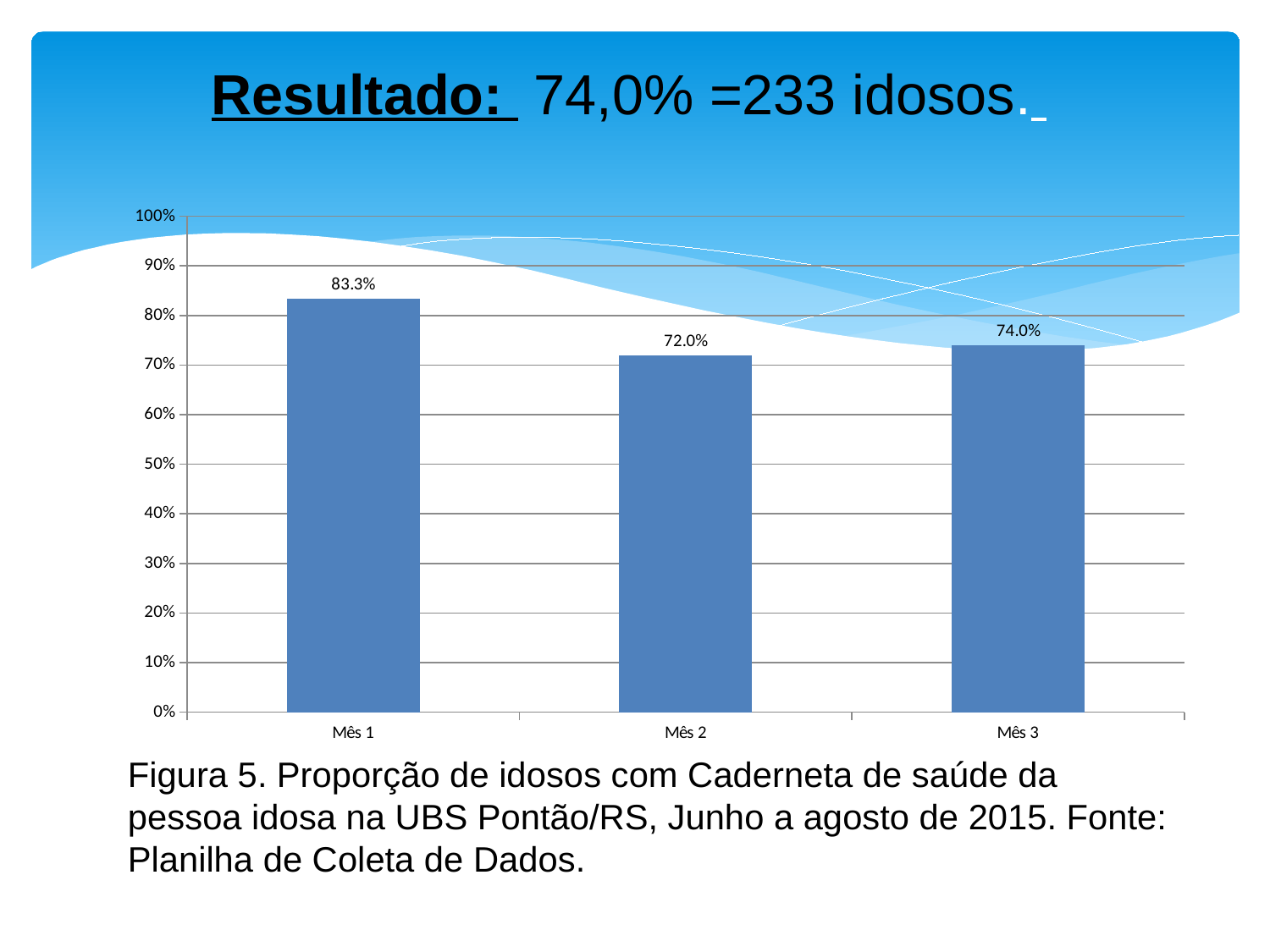
What is the difference between the values for Mês 3 and Mês 2? 2.0% How many months are shown on the x axis? 3 What is the difference between the values for Mês 1 and Mês 2? 11.3% What is the value for Mês 3? 74.0% Is the value for Mês 2 greater or less than 80%? less What kind of chart is shown on the slide? bar chart What is the value for Mês 2? 72.0% Which month has the highest value? Mês 1 Which month has the lowest value? Mês 2 Which is larger, the value for Mês 1 or the value for Mês 3? Mês 1 What is the value for Mês 1? 83.3% What is the figure number given in the caption below the chart? Figura 5